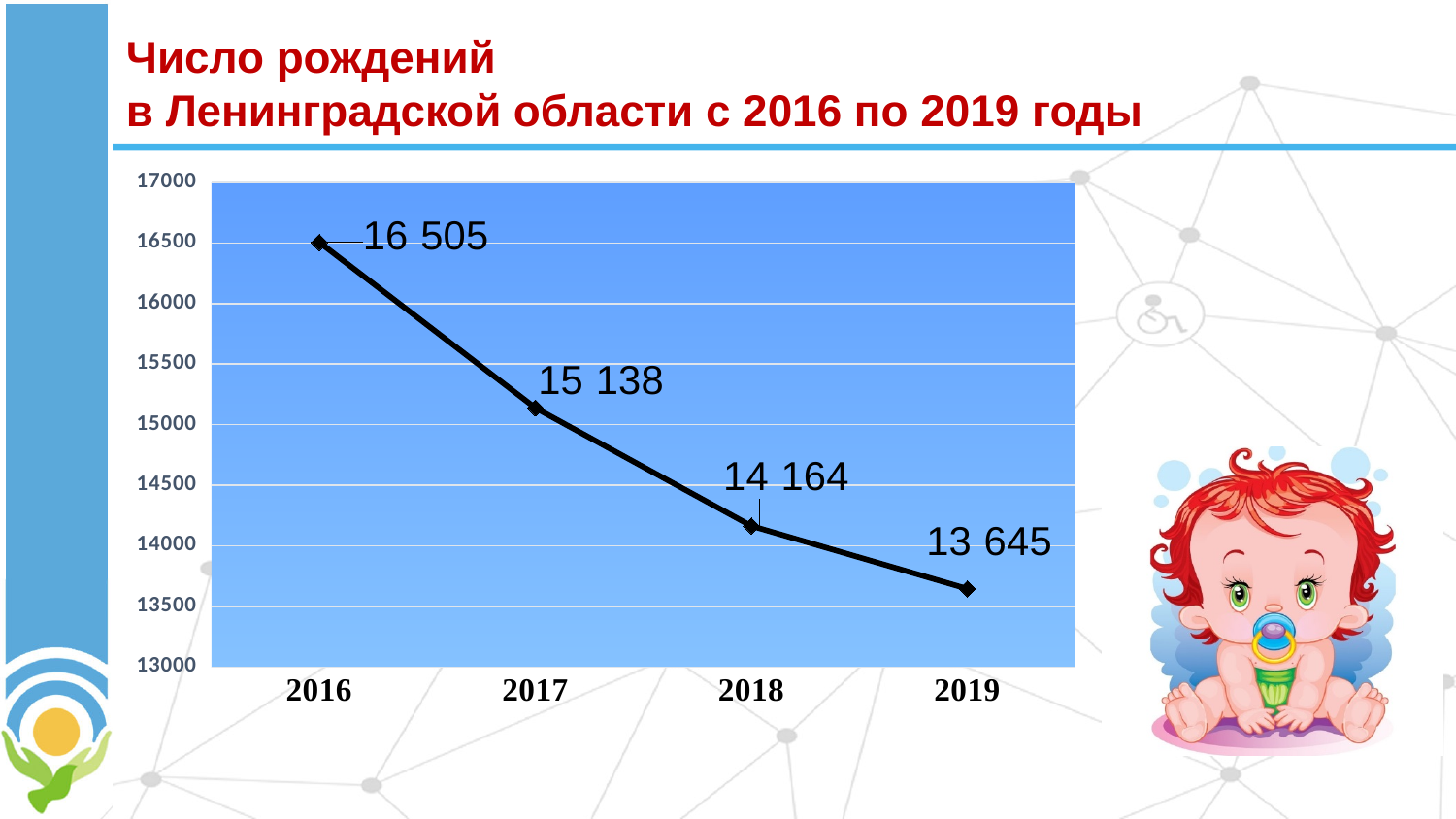
What kind of chart is shown on the slide? line chart What is the difference between the number of births in 2016 and 2019? 2 860 Which year has the highest number of births? 2016 What is the number of births in 2016? 16 505 What is the number of births in 2018? 14 164 What is the number of births in 2017? 15 138 Which year has more births, 2017 or 2018? 2017 Which year has the lowest number of births? 2019 How many years are plotted on the chart? 4 What is the number of births in 2019? 13 645 What is the difference between the number of births in 2017 and 2018? 974 Do the values rise or fall from 2016 to 2019? fall